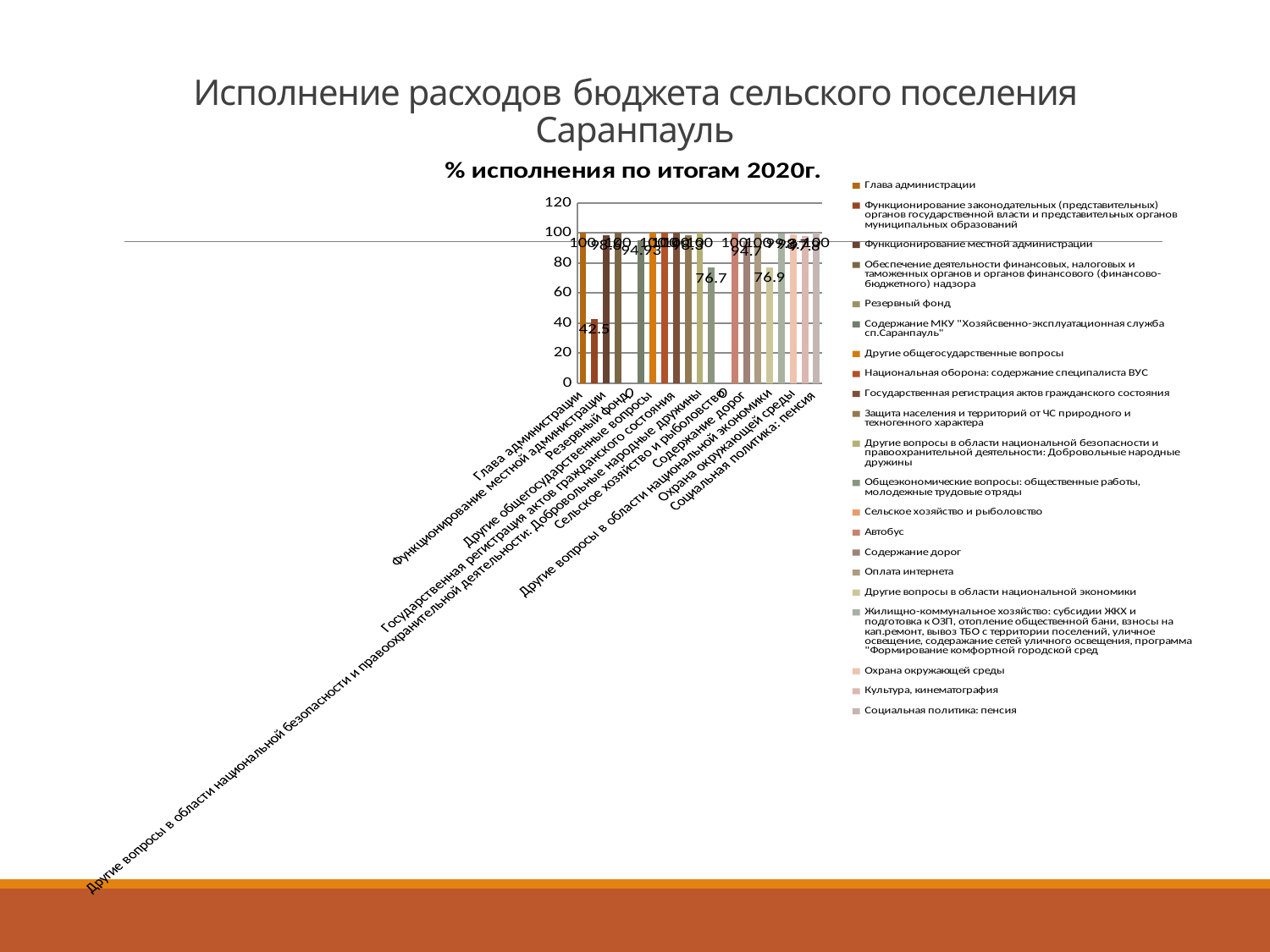
What is the highest value shown on the vertical axis of the chart? 120 Is the value for Глава администрации greater or less than 80? greater What kind of chart is shown on the slide? bar chart Is the value for Социальная политика: пенсия greater or less than 80? greater What is the lowest data label value shown on the chart? 0 Do any bars on the chart exceed 100 on the vertical axis? No What is the title of the chart? % исполнения по итогам 2020г. How many series does the chart legend list? 21 Which is larger, the value for Глава администрации or the lowest bar labelled 42.5? Глава администрации